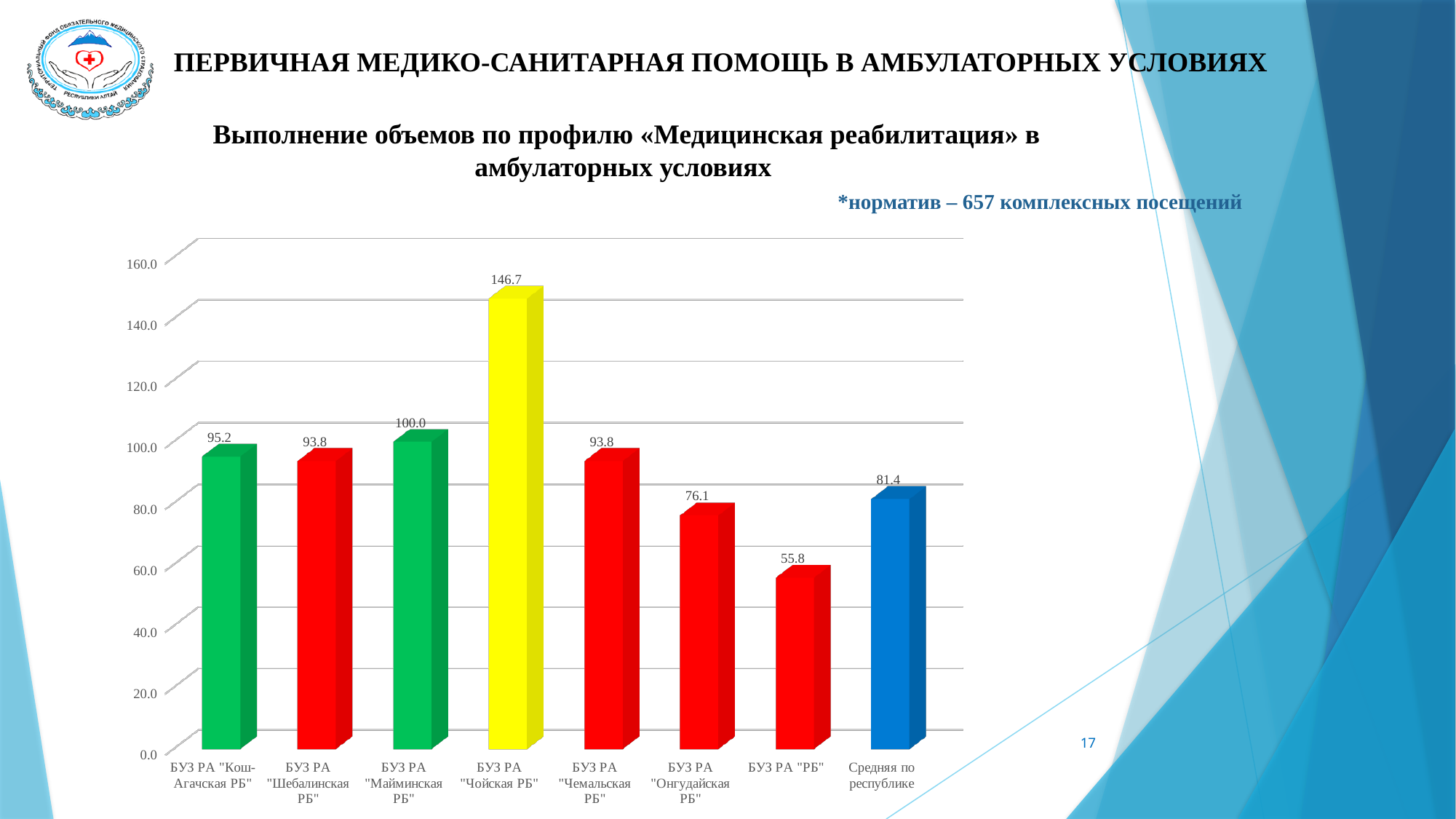
What is the difference between the values for БУЗ РА "Чойская РБ" and БУЗ РА "РБ"? 90.9 How many categories are shown on the x axis? 8 Which category has the lowest value? БУЗ РА "РБ" What is the value for БУЗ РА "Кош-Агачская РБ"? 95.2 What is the value for БУЗ РА "Онгудайская РБ"? 76.1 What colour is the bar for БУЗ РА "Чойская РБ"? yellow What is the value for Средняя по республике? 81.4 What is the value for БУЗ РА "Чойская РБ"? 146.7 Is the value for БУЗ РА "Чемальская РБ" greater or less than 80.0? greater Which category has the highest value? БУЗ РА "Чойская РБ" What kind of chart is shown on the slide? bar chart Which is larger, the value for БУЗ РА "Майминская РБ" or the value for БУЗ РА "Онгудайская РБ"? БУЗ РА "Майминская РБ"